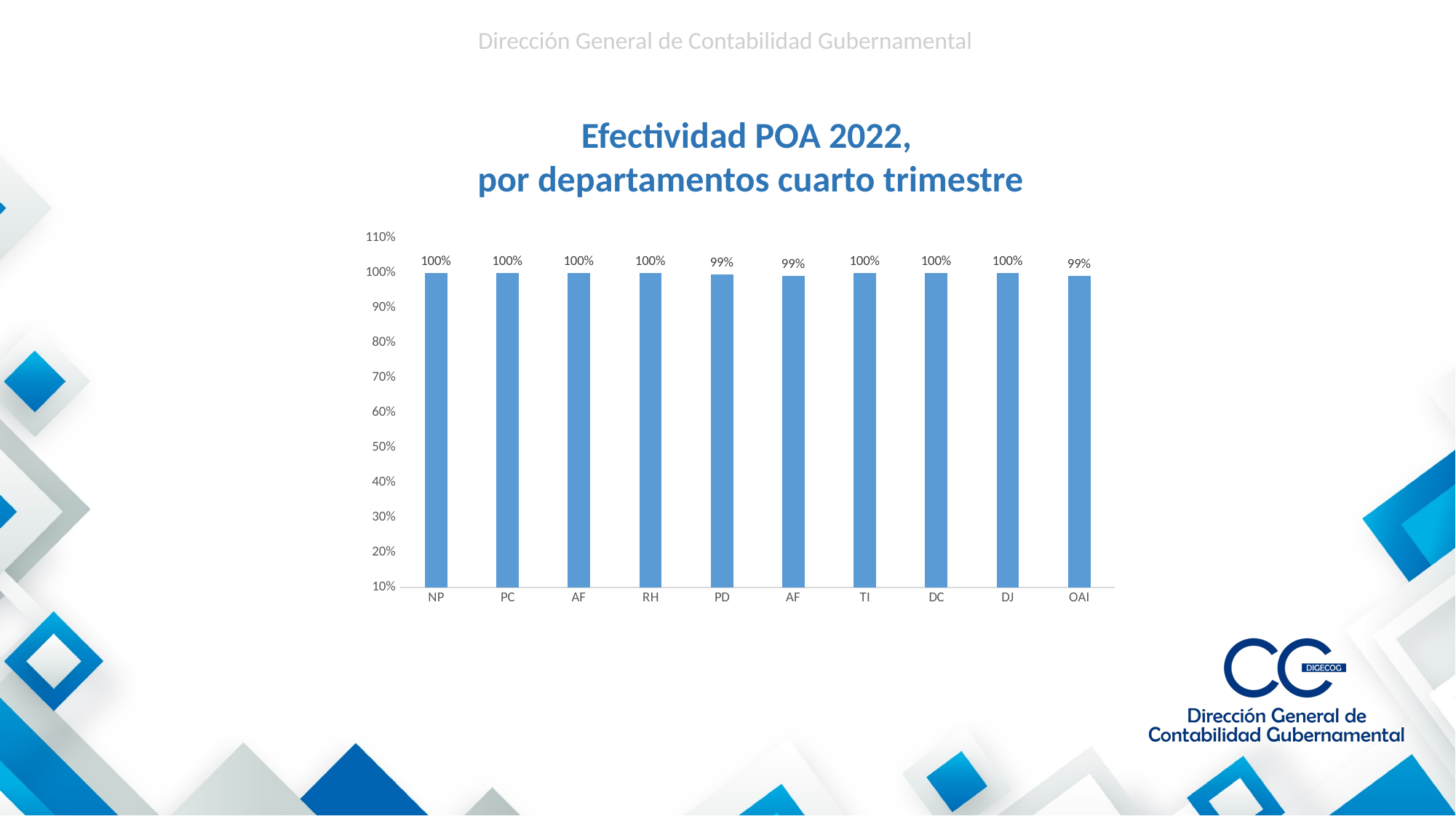
Which is larger, the value for PD or the value for TI? TI What is the value for TI? 100% What kind of chart is shown? Bar chart What is the value for DJ? 100% Is the value for OAI greater or less than 90%? greater How many departments have a value of 99%? 3 How many departments are shown on the x axis? 10 What is the value for PD? 99% What is the value for NP? 100% What is the value for OAI? 99% What is the difference between the values for NP and PD? 1% What is the title of the chart? Efectividad POA 2022, por departamentos cuarto trimestre